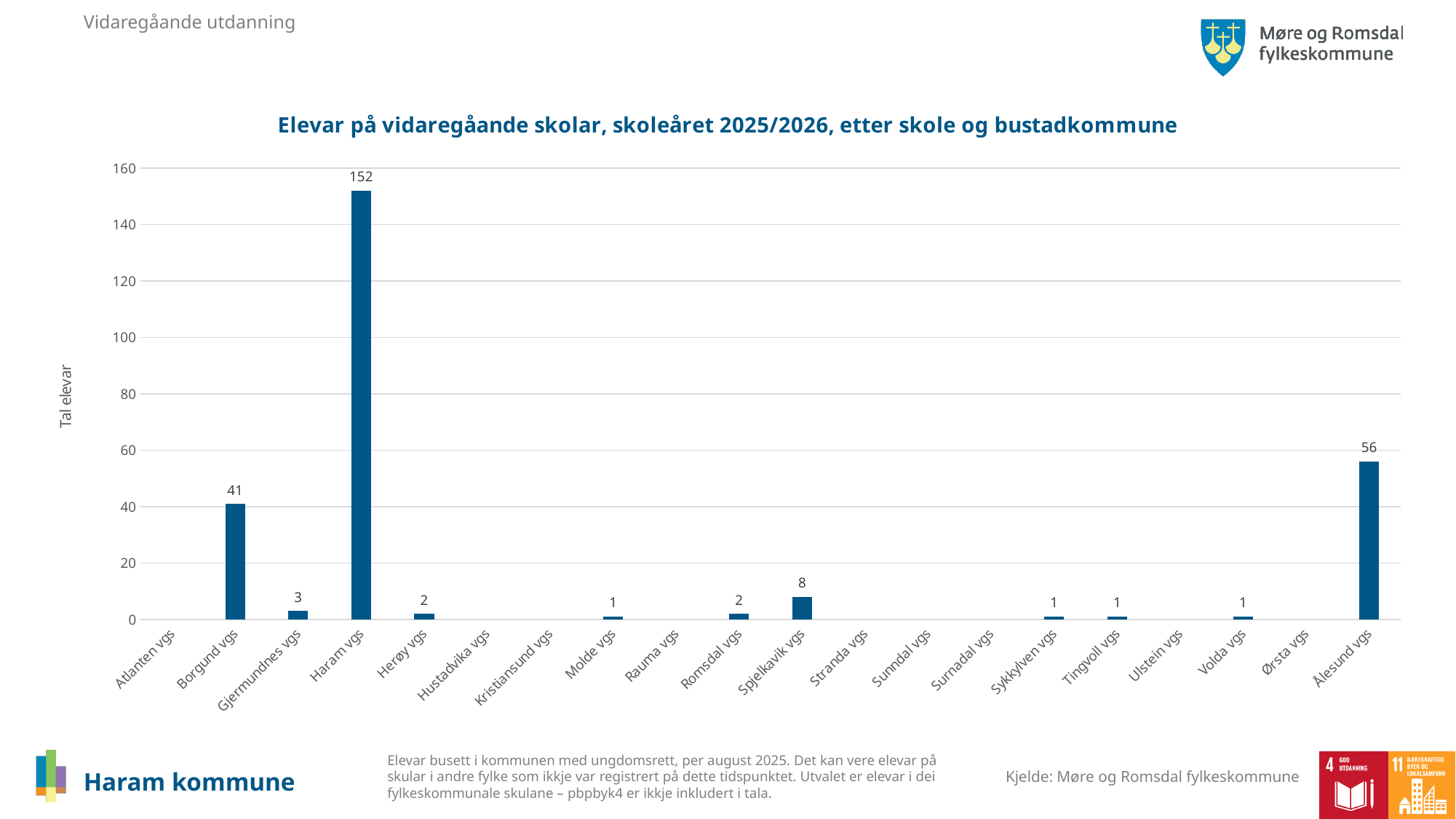
What is the value for Ålesund vgs? 56 What is the value for Spjelkavik vgs? 8 What is the difference between the values for Ålesund vgs and Borgund vgs? 15 Which school has the highest number of students? Haram vgs What kind of chart is shown on the slide? Bar chart What is the difference between the values for Haram vgs and Ålesund vgs? 96 What is the value for Borgund vgs? 41 Which is larger, the value for Borgund vgs or the value for Spjelkavik vgs? Borgund vgs How many schools are shown on the x axis? 20 Is the value for Haram vgs greater or less than 140? greater What is the value for Gjermundnes vgs? 3 What is the value for Haram vgs? 152